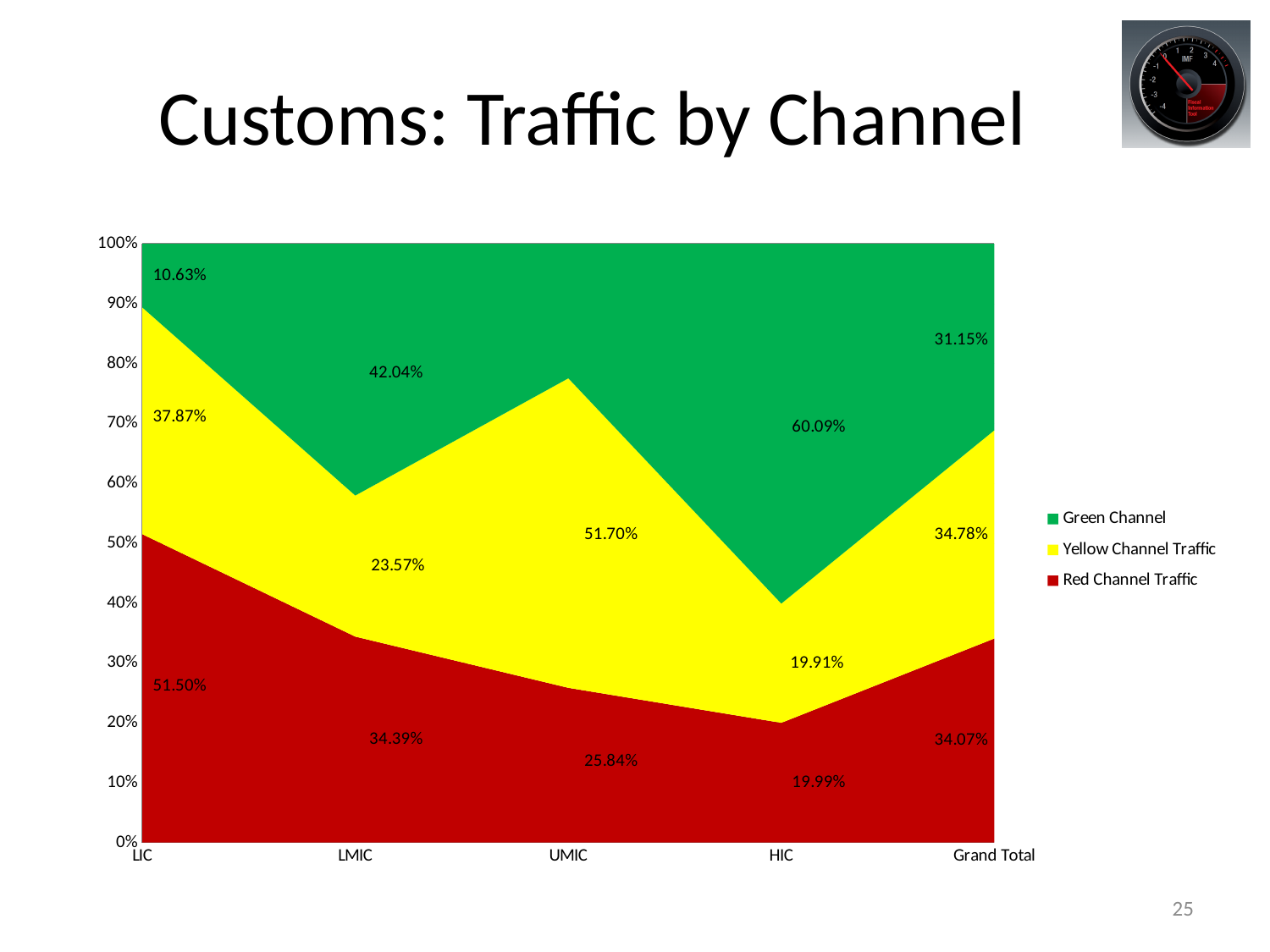
What is the difference between the Green Channel values for HIC and LIC? 49.46% Which category has the lowest Yellow Channel Traffic value? HIC How many series does the legend list? 3 Which is larger, the Red Channel Traffic value for LMIC or for UMIC? LMIC Which category has the highest Red Channel Traffic value? LIC What is the Yellow Channel Traffic value for UMIC? 51.70% What is the title of the slide? Customs: Traffic by Channel What is the Green Channel value for HIC? 60.09% How many categories are shown on the x axis? 5 What is the Red Channel Traffic value for LIC? 51.50% What kind of chart is shown on the slide? Stacked area chart What is the Green Channel value for Grand Total? 31.15%